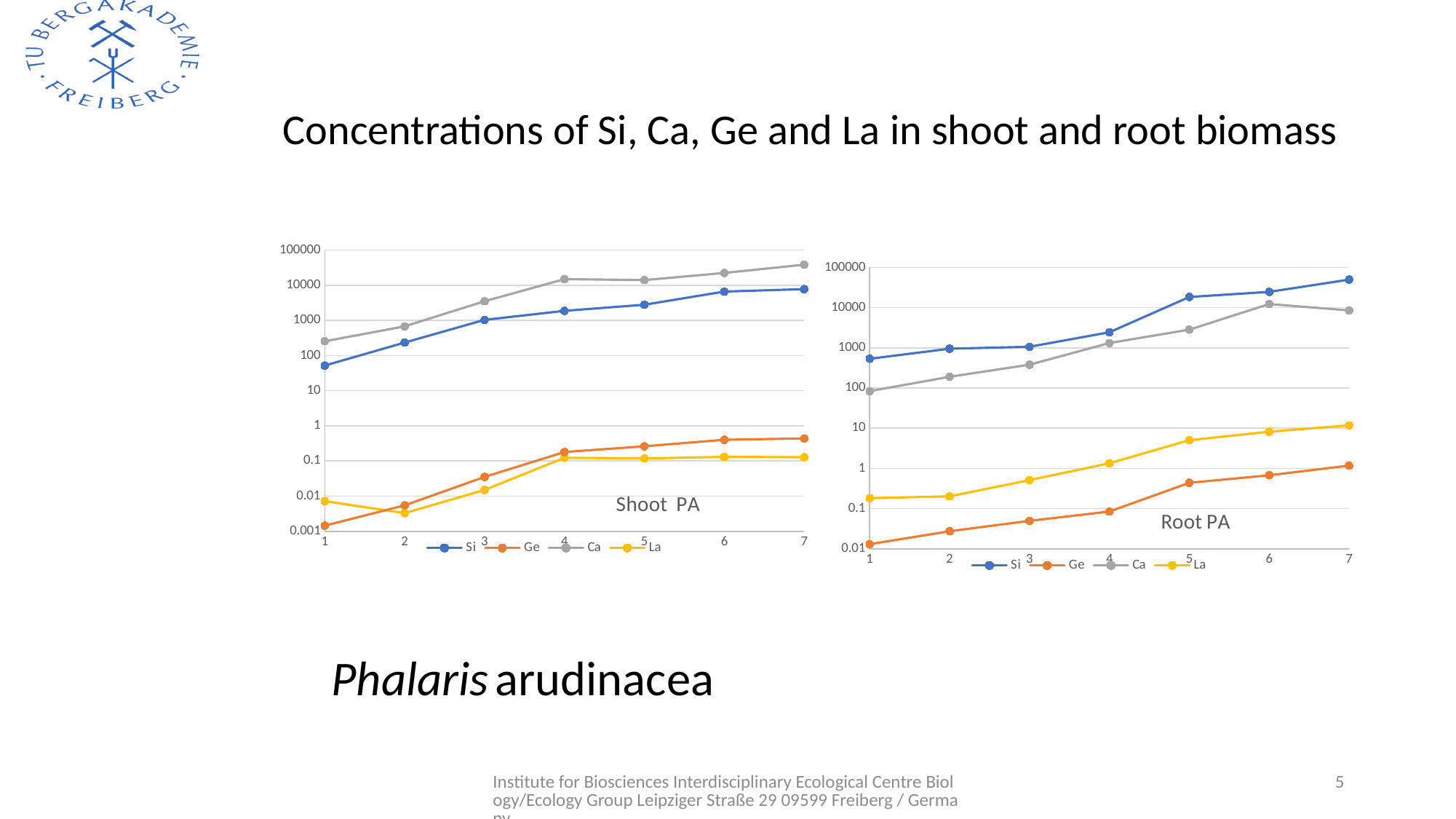
In the Root PA chart, does the Si series rise or fall from point 1 to point 7? rise In the Root PA chart, which series has the highest value at point 7? Si How many points are on the x axis of the Shoot PA chart? 7 In the Root PA chart, is the value for Si at point 1 greater or less than 100? greater In the Root PA chart, which series has the lowest value at point 1? Ge In the Shoot PA chart, is the value for Ca at point 7 greater or less than 10000? greater In the Shoot PA chart, which series has the highest value at point 7? Ca How many series does the legend of the Root PA chart list? 4 In the Shoot PA chart, is the value for Si at point 1 greater or less than 100? less In the Root PA chart, which is larger at point 1, Si or Ca? Si What kind of chart is the Shoot PA chart? line chart